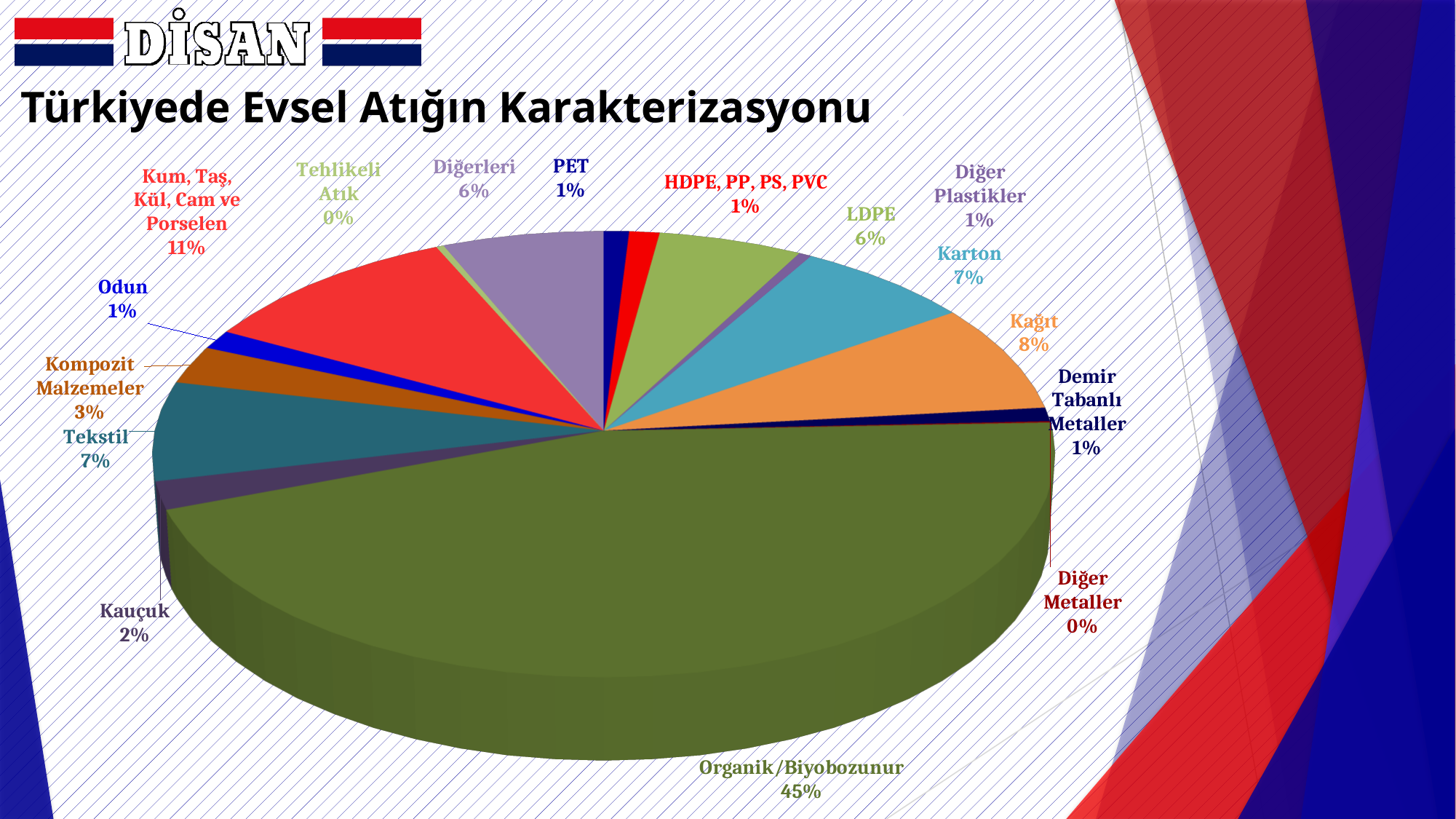
What is the title of the chart? Türkiyede Evsel Atığın Karakterizasyonu How many categories are shown in the pie chart? 16 What is the value shown for Kompozit Malzemeler? 3% Which is larger, the share for Kağıt or the share for LDPE? Kağıt What share of the pie does Organik/Biyobozunur have? 45% What is the difference between the shares of Karton and Kompozit Malzemeler? 4% What is the value shown for Kauçuk? 2% What is the value shown for Kum, Taş, Kül, Cam ve Porselen? 11% Which category has the largest share of the pie? Organik/Biyobozunur What is the value shown for Kağıt? 8% What kind of chart is shown on the slide? Pie chart What is the difference between the shares of Organik/Biyobozunur and Kum, Taş, Kül, Cam ve Porselen? 34%